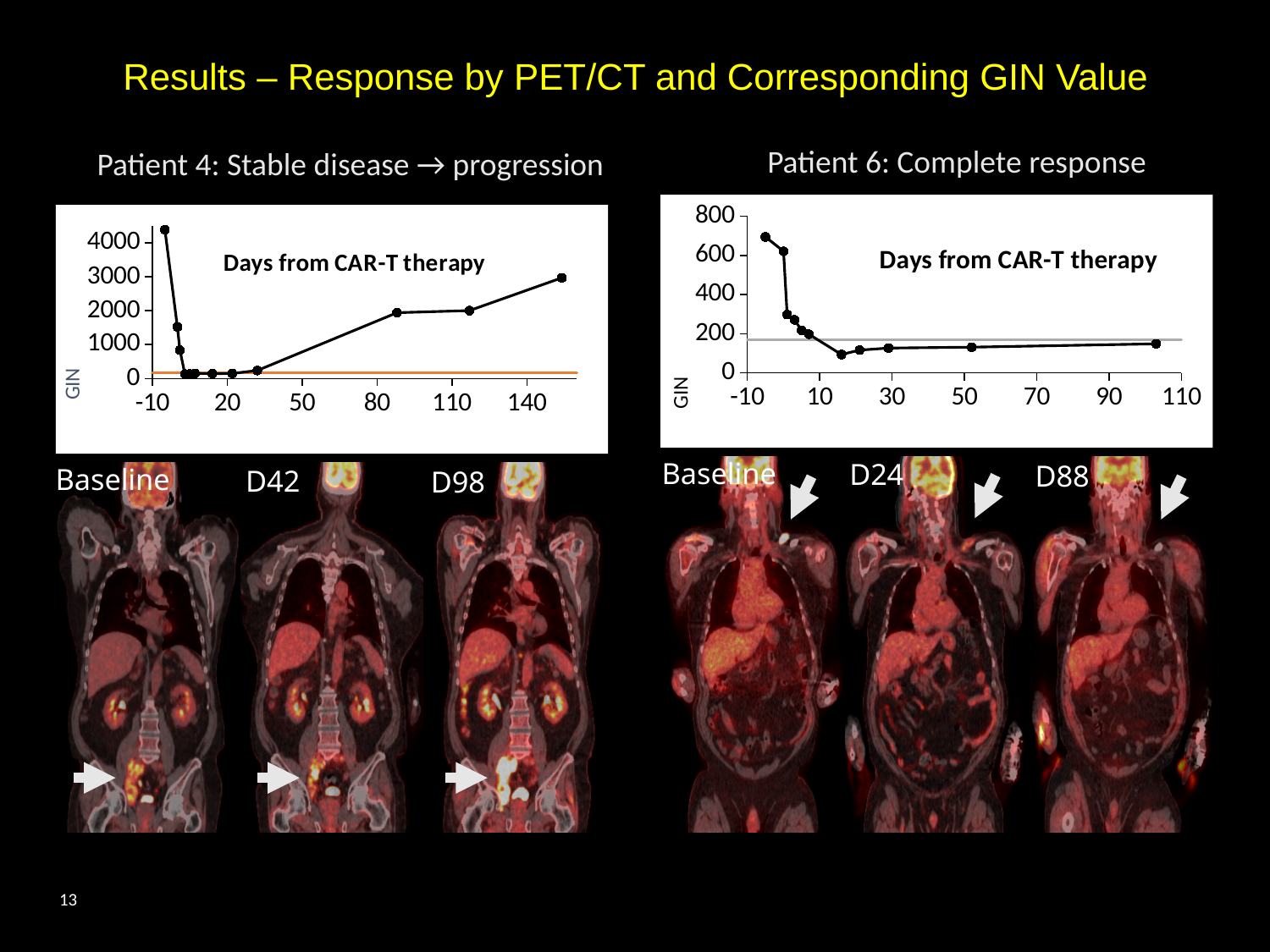
In the Patient 4 chart, is the last (rightmost) GIN value greater or less than 2000? greater What kind of chart is shown for Patient 4: Stable disease → progression? line chart In the Patient 4 chart, do the GIN values rise or fall between day 20 and day 140? rise What text label appears inside the plot area of the Patient 6 chart? Days from CAR-T therapy What is the label on the vertical axis of the Patient 4 chart? GIN In the Patient 6 chart, is the first (leftmost) GIN value greater or less than 600? greater In the Patient 6 chart, do the GIN values rise or fall over the first 10 days from CAR-T therapy? fall In the Patient 4 chart, which point has the highest GIN value: the first point before day 0 or the last point near day 150? the first point before day 0 In the Patient 6 chart, which is larger: the GIN value at the first point or the GIN value at the last point? the first point In the Patient 4 chart, is the first (leftmost) GIN value greater or less than 4000? greater What kind of chart is shown for Patient 6: Complete response? line chart